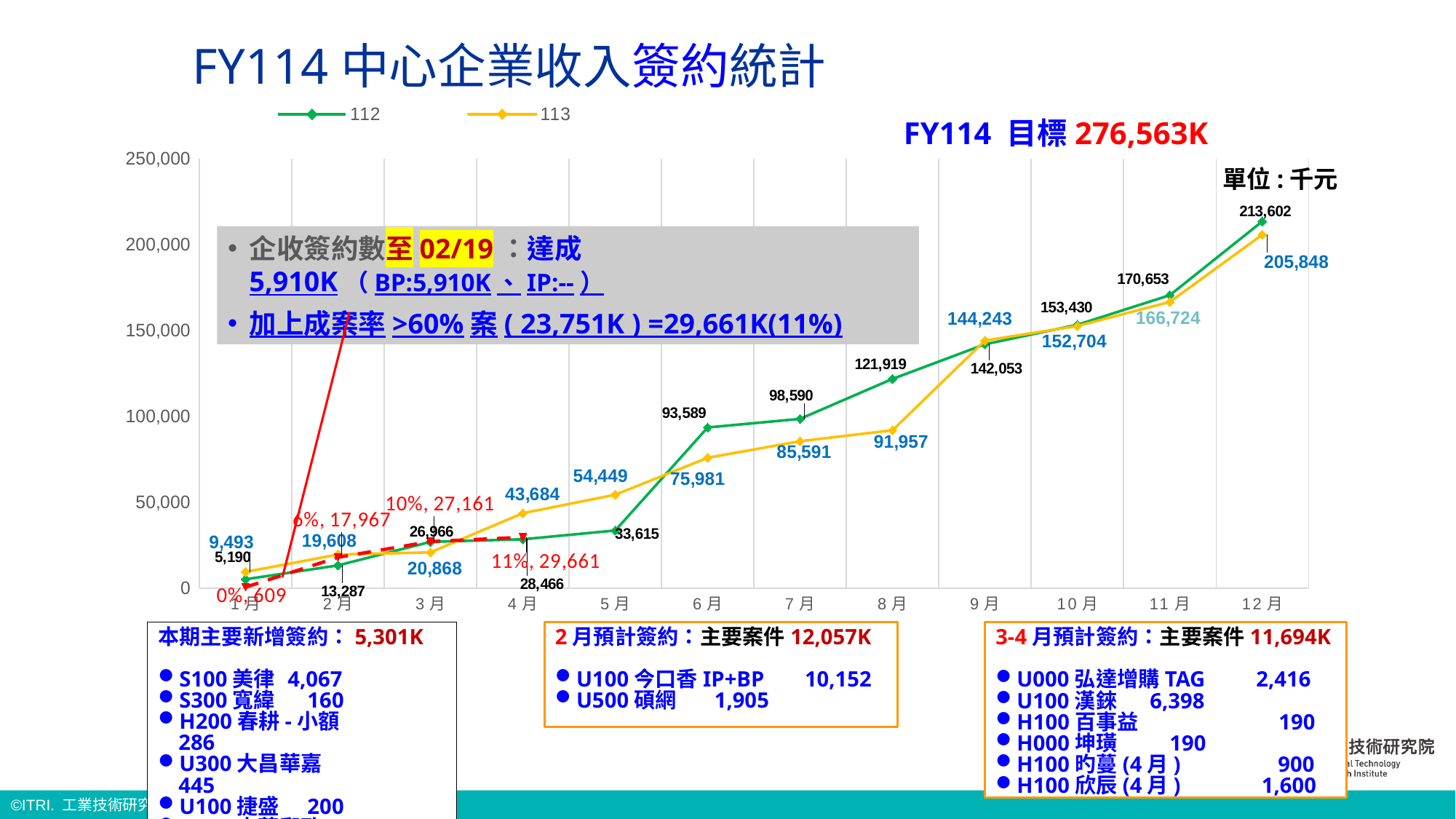
How many series does the chart legend list? 2 What is the value of series 112 at 8月? 121,919 In which month is series 112 at its lowest value? 1月 What is the FY114 target (目標) stated on the slide? 276,563K How many months are plotted along the x axis? 12 In which month does series 113 reach its highest value? 12月 What kind of chart is shown on the slide? line chart What is the value of series 113 at 6月? 75,981 At 4月, which series has the larger value, 112 or 113? 113 What is the value of series 112 at 12月? 213,602 What is the difference between series 112 and series 113 at 12月? 7,754 Does series 113 generally rise or fall from 1月 to 12月? rise